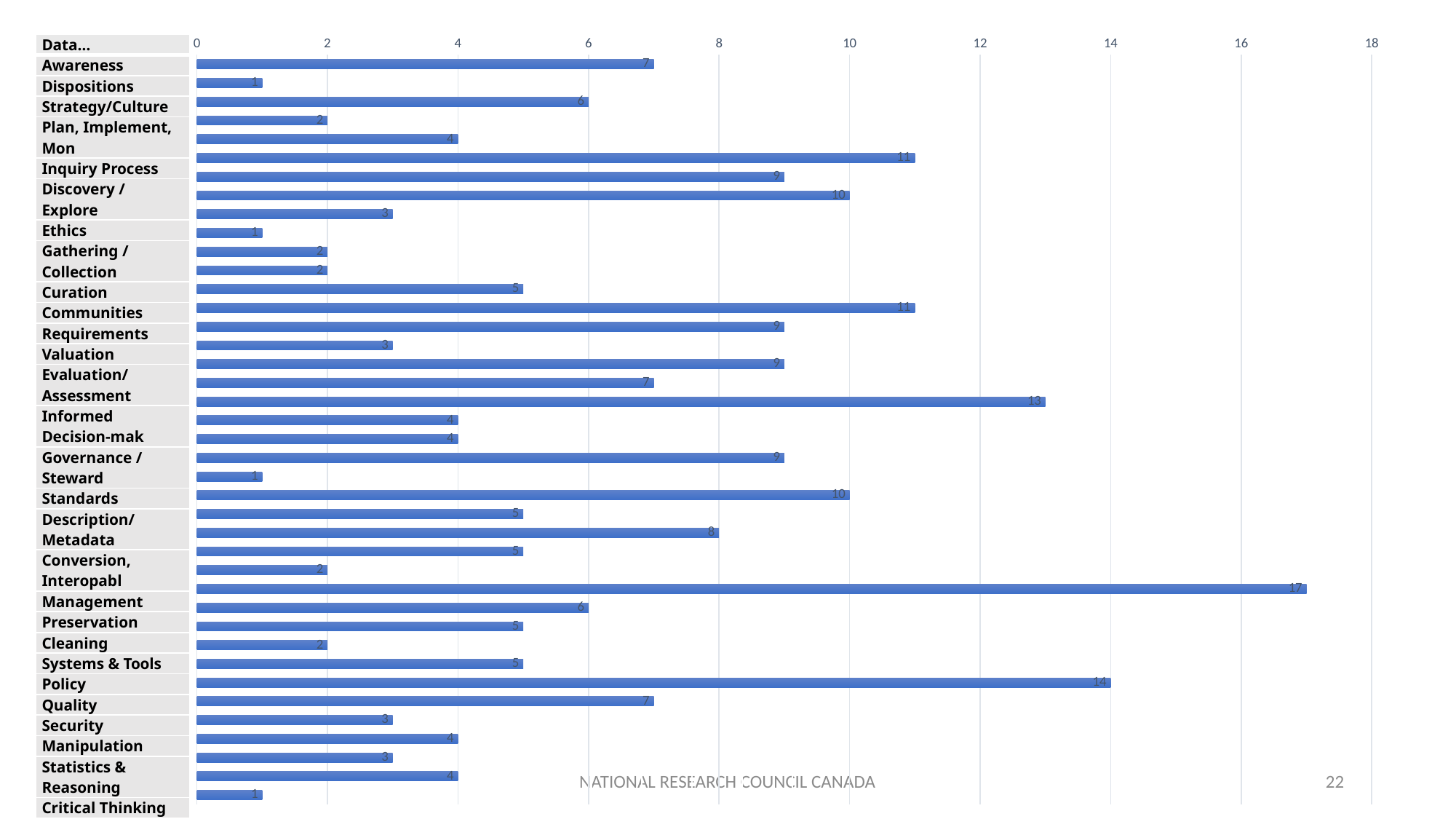
What kind of chart is shown on the slide? bar chart What is the highest tick value shown on the horizontal axis? 18 How many bars in the chart have a value of 10 or more? 7 What is the largest value shown by any bar in the chart? 17 What is the value of the topmost bar in the chart? 7 What is the smallest value shown by any bar in the chart? 1 How many bars in the chart have a value of 1? 4 Is the longest bar in the chart greater or less than 16? greater What is the value of the bottommost bar in the chart? 1 What colour are the bars in the chart? blue What is the difference between the longest bar (17) and the shortest bar (1)? 16 What is the difference between the longest bar (17) and the second-longest bar (14)? 3